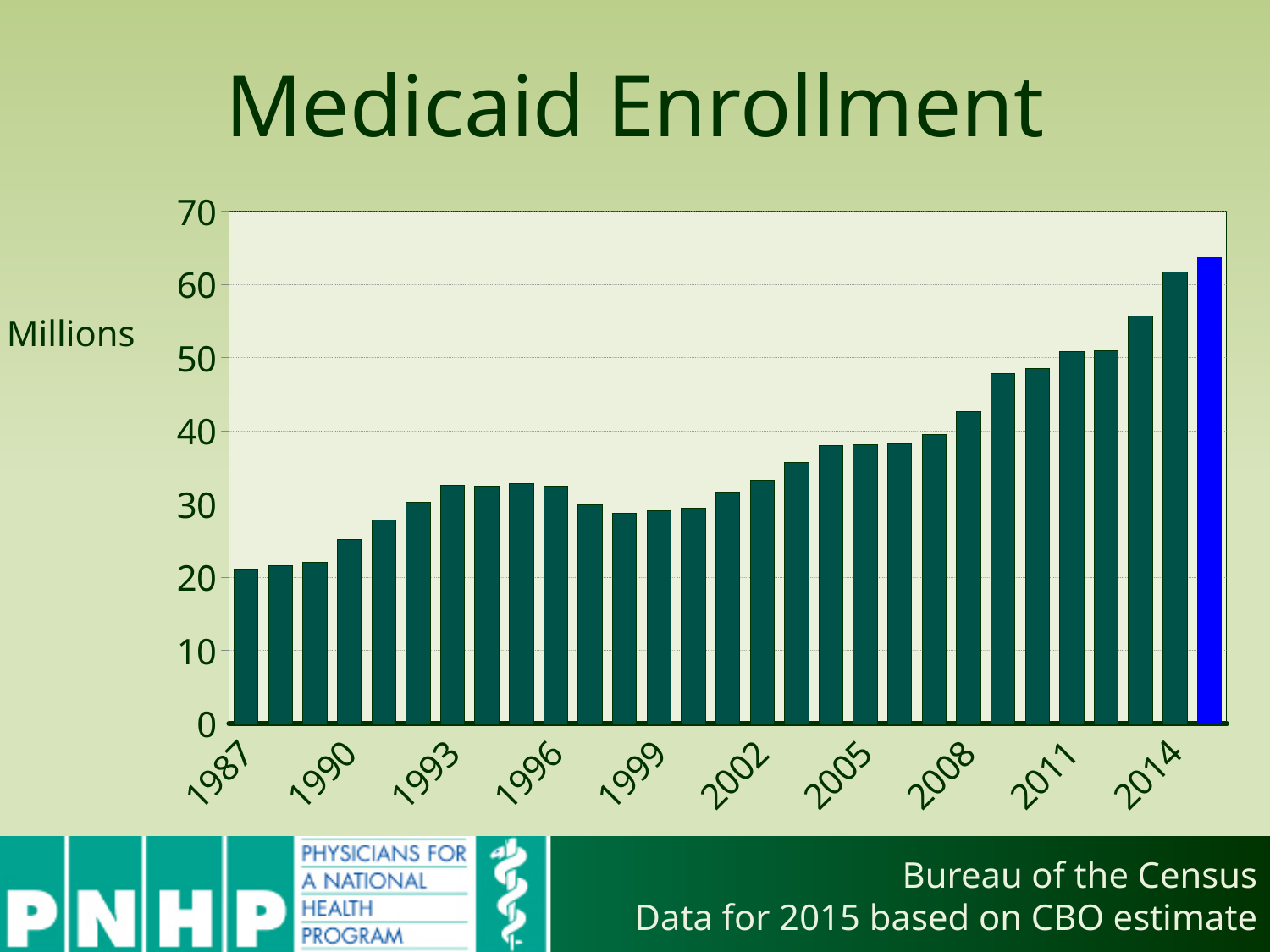
Is the value for 2008 greater or less than 40? greater Is the value for 2005 greater or less than 40? less What kind of chart is shown on the slide? bar chart Which year has the larger Medicaid enrollment, 1990 or 2011? 2011 Overall, do the values rise or fall from 1987 to 2015? rise Which year has the highest Medicaid enrollment? 2015 Which year has the lowest Medicaid enrollment? 1987 In what unit are the values on the vertical axis expressed? Millions Is the value for 1987 greater or less than 30? less What is the title of the chart? Medicaid Enrollment